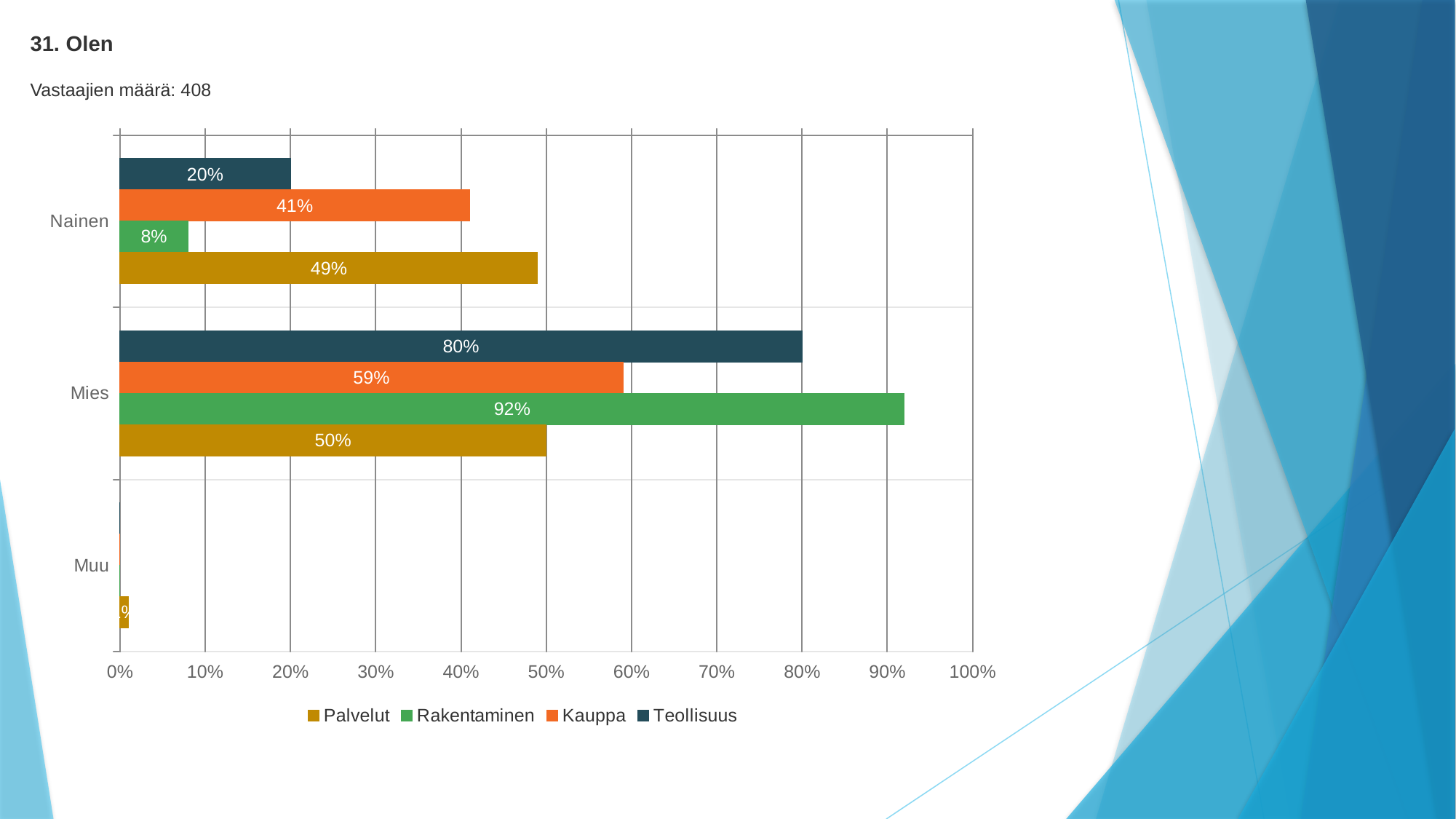
How many categories are shown on the vertical axis? 3 Which series has the highest value in the Mies category? Rakentaminen What is the value for Rakentaminen in the Mies category? 92% What is the value for Teollisuus in the Mies category? 80% How many series does the legend list? 4 Which series has the lowest value in the Nainen category? Rakentaminen What is the difference between the Teollisuus values for Mies and Nainen? 60% What is the number of respondents (Vastaajien määrä) stated on the slide? 408 What is the value for Palvelut in the Nainen category? 49% What is the value for Kauppa in the Nainen category? 41% Which is larger: the Kauppa value for Mies or the Palvelut value for Mies? Kauppa value for Mies What kind of chart is shown on the slide? bar chart